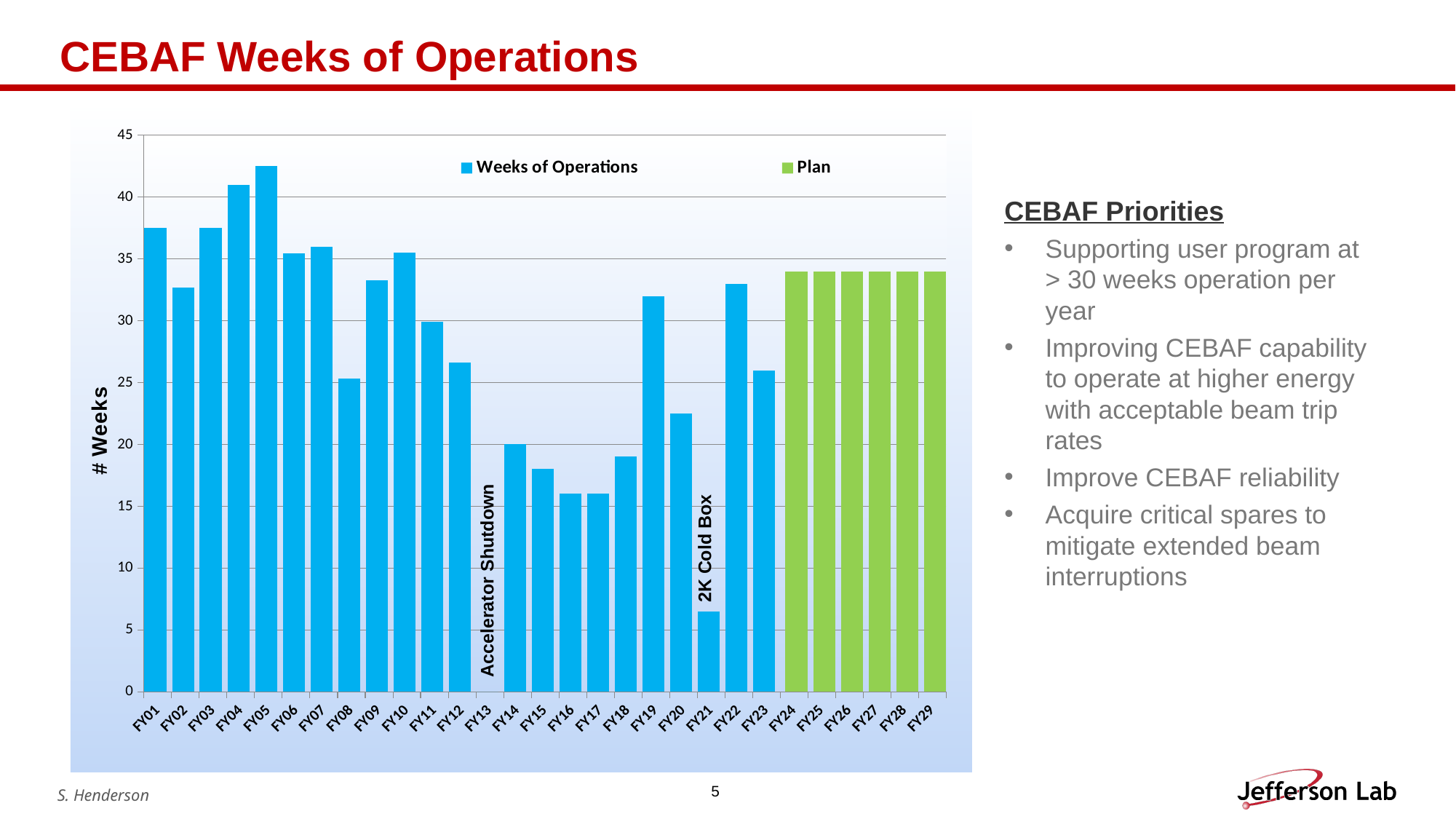
How many fiscal-year categories are shown on the x axis? 29 Is the value for FY05 greater or less than 40? greater Which is larger, the value for FY04 or the value for FY02? FY04 What label is written in the chart at the FY13 position where no bar is plotted? Accelerator Shutdown How many series does the chart legend list? 2 Is the value for FY16 greater or less than 20? less What kind of chart is shown on the slide? bar chart Which fiscal year with a plotted bar has the lowest number of weeks of operations? FY21 Is the value for FY21 greater or less than 10? less Which fiscal year has the highest number of weeks of operations? FY05 Do the values rise or fall from FY05 to FY08? fall